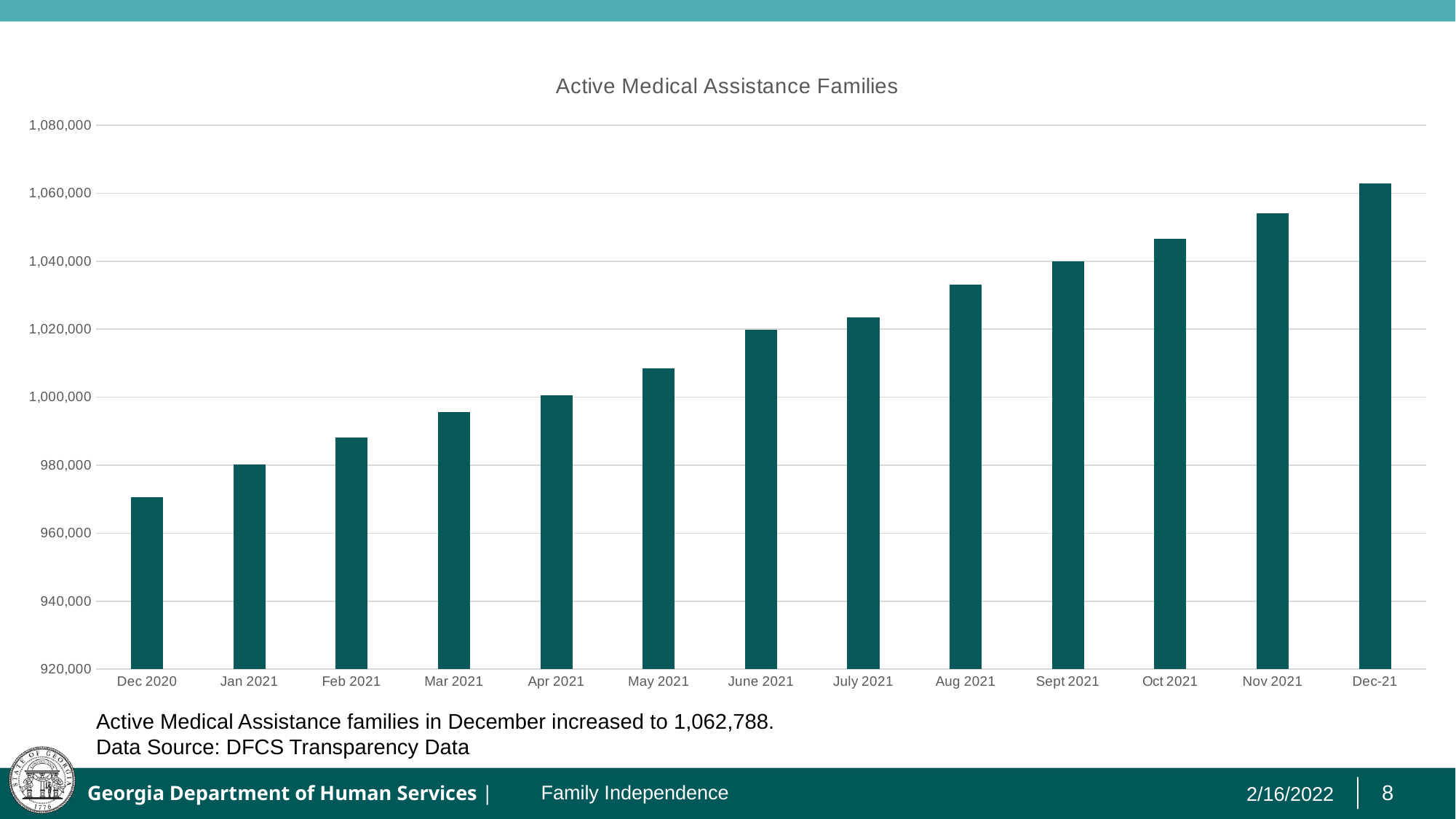
What kind of chart is shown on the slide? Bar chart What is the title of the chart? Active Medical Assistance Families Is the value for Oct 2021 greater or less than 1,040,000? greater Which month has the lowest number of active Medical Assistance families? Dec 2020 Is the value for Aug 2021 greater or less than 1,040,000? less Do the values rise or fall from Dec 2020 to Dec-21? Rise Which month has the highest number of active Medical Assistance families? Dec-21 How many months are plotted on the chart? 13 Which is larger, the value for Dec 2020 or the value for Dec-21? Dec-21 What was the number of active Medical Assistance families in December 2021? 1,062,788 Is the value for Dec 2020 greater or less than 980,000? less